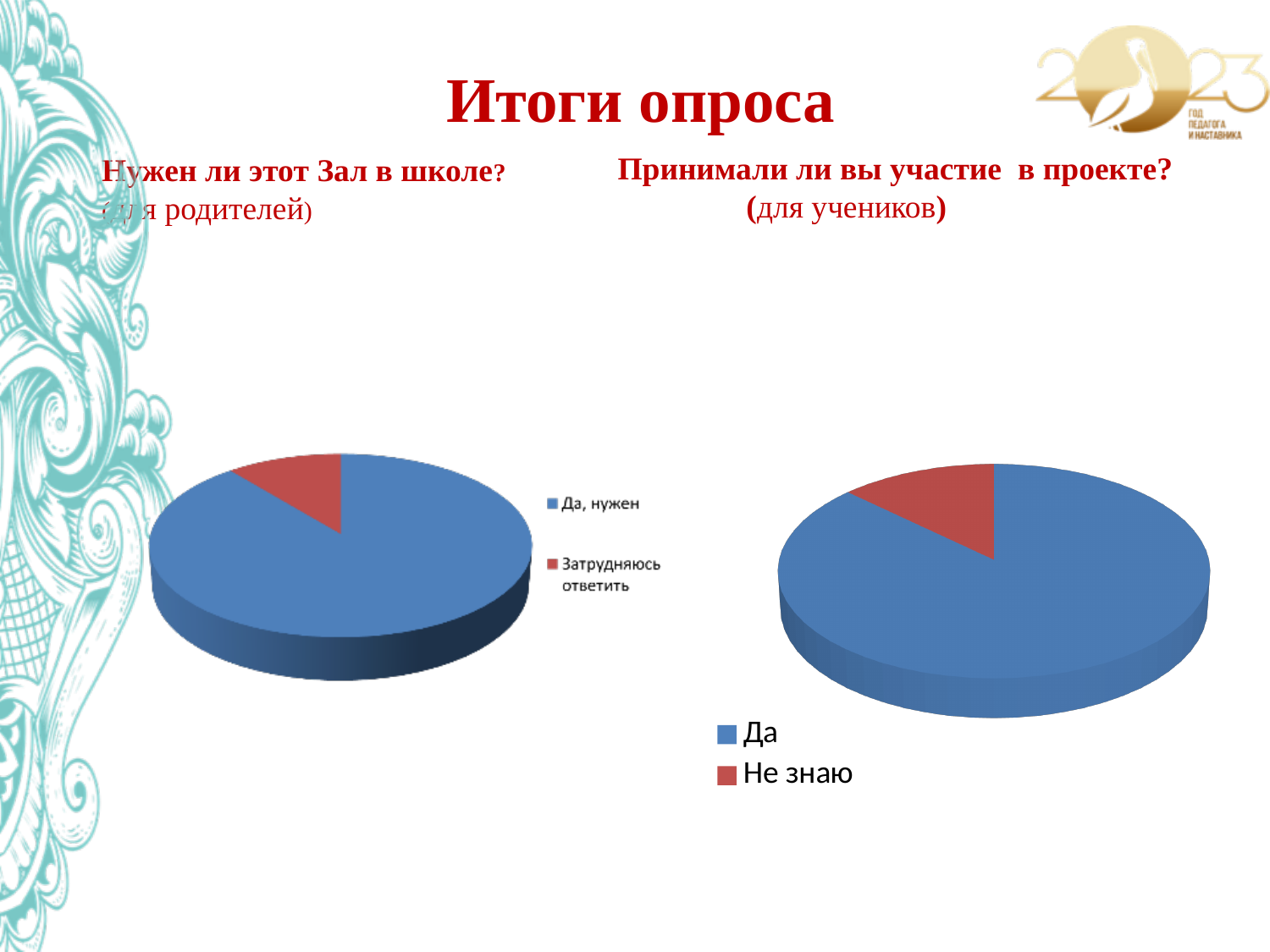
In the right chart (Принимали ли вы участие в проекте?), how many entries does the legend list? 2 In the left chart (Нужен ли этот Зал в школе?), what colour is the slice for Затрудняюсь ответить? red In the right chart (Принимали ли вы участие в проекте?), which category has the smallest slice? Не знаю In the right chart (Принимали ли вы участие в проекте?), which category has the largest slice? Да In the left chart (Нужен ли этот Зал в школе?), how many slices does the pie have? 2 In the right chart (Принимали ли вы участие в проекте?), which slice is larger: Да or Не знаю? Да What kind of chart is the left chart (Нужен ли этот Зал в школе?)? pie chart In the left chart (Нужен ли этот Зал в школе?), which category has the largest slice? Да, нужен In the right chart (Принимали ли вы участие в проекте?), how many slices does the pie have? 2 In the left chart (Нужен ли этот Зал в школе?), how many entries does the legend list? 2 What kind of chart is the right chart (Принимали ли вы участие в проекте?)? pie chart In the left chart (Нужен ли этот Зал в школе?), which category has the smallest slice? Затрудняюсь ответить